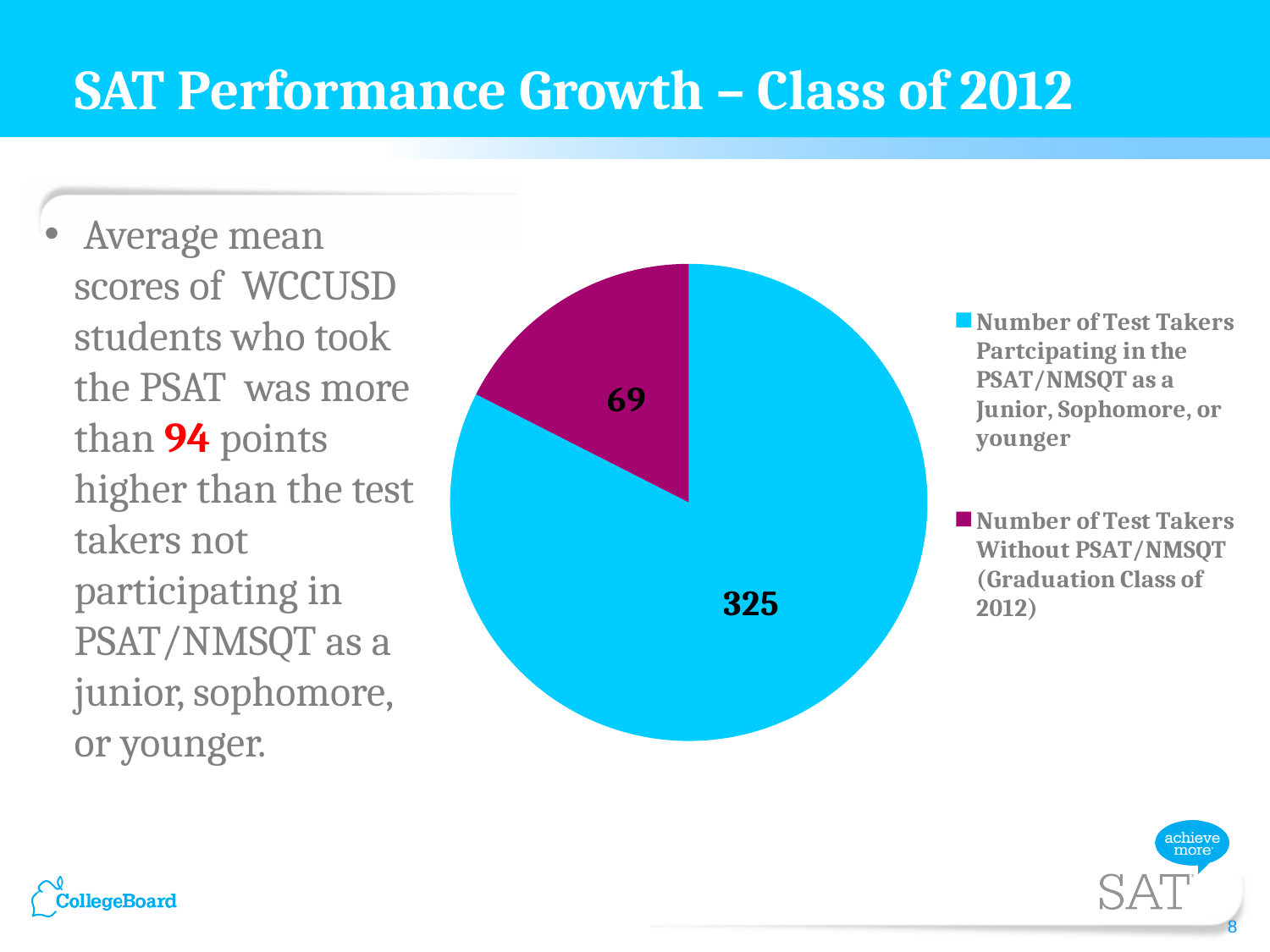
Which slice of the pie chart is the smallest? Number of Test Takers Without PSAT/NMSQT (Graduation Class of 2012) What share of the pie does the Number of Test Takers Without PSAT/NMSQT slice represent, to the nearest whole percent? 18% Which is larger: the number of test takers participating in the PSAT/NMSQT or the number without the PSAT/NMSQT? Number of Test Takers Participating in the PSAT/NMSQT as a Junior, Sophomore, or younger What is the difference between the number of test takers who participated in the PSAT/NMSQT and those without the PSAT/NMSQT? 256 What is the value for Number of Test Takers Participating in the PSAT/NMSQT as a Junior, Sophomore, or younger? 325 Which slice of the pie chart is the largest? Number of Test Takers Participating in the PSAT/NMSQT as a Junior, Sophomore, or younger What kind of chart is shown on the slide? Pie chart What is the total number of test takers represented in the pie chart? 394 What colour is the slice for Number of Test Takers Without PSAT/NMSQT (Graduation Class of 2012)? Magenta (purple) How many entries does the legend of the pie chart list? 2 How many slices does the pie chart have? 2 What is the value for Number of Test Takers Without PSAT/NMSQT (Graduation Class of 2012)? 69